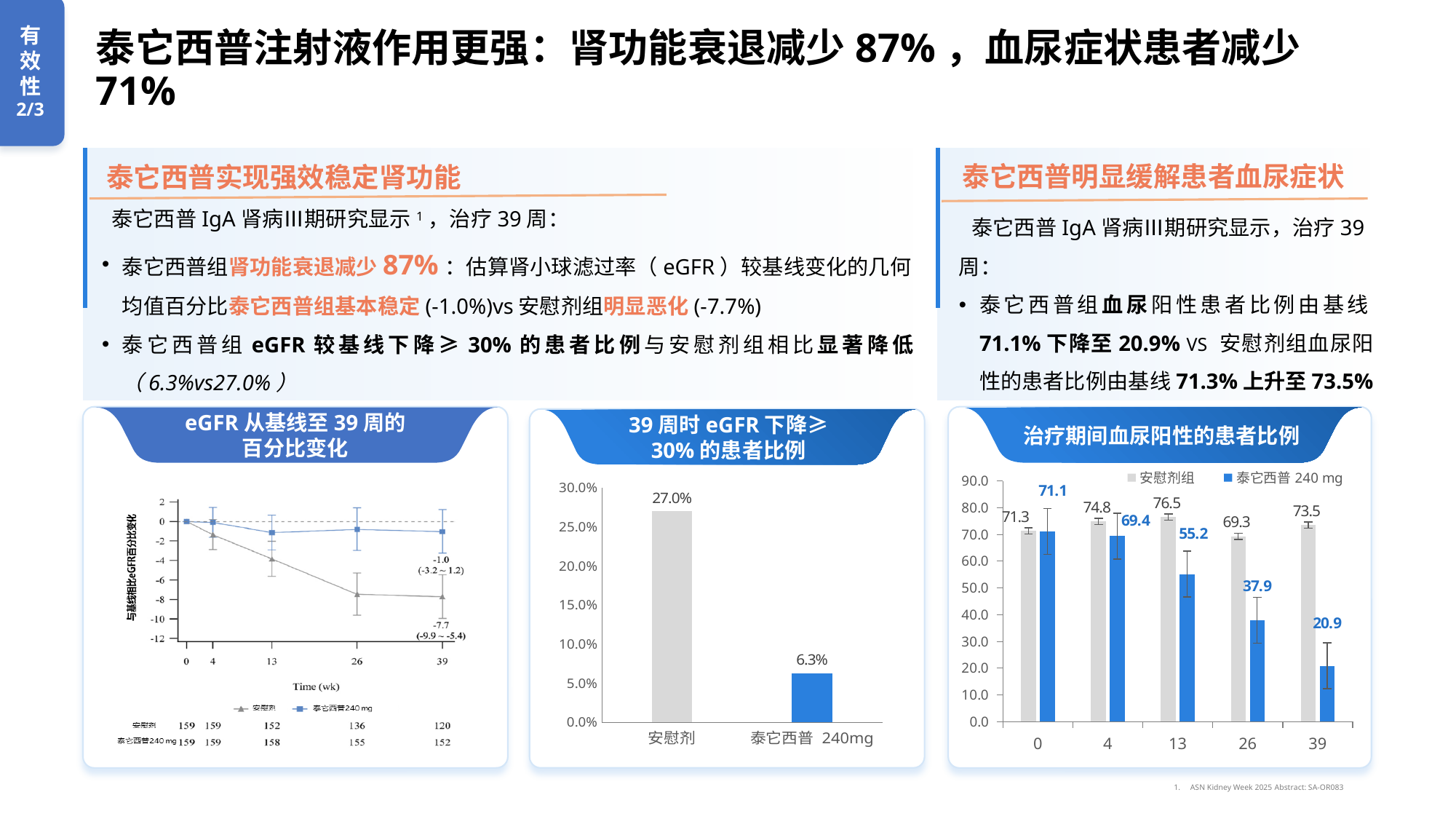
In the chart titled '39 周时 eGFR 下降≥30% 的患者比例', what is the value for 安慰剂? 27.0% In the chart titled '治疗期间血尿阳性的患者比例', what is the value for 泰它西普 240 mg at week 39? 20.9 In the chart titled '治疗期间血尿阳性的患者比例', does the 泰它西普 240 mg value rise or fall from week 0 to week 39? Fall In the chart titled '39 周时 eGFR 下降≥30% 的患者比例', what is the difference between the 安慰剂 value and the 泰它西普 240mg value? 20.7% In the chart titled '治疗期间血尿阳性的患者比例', how many series does the legend list? 2 In the chart titled 'eGFR 从基线至 39 周的百分比变化', what is the value for 泰它西普240 mg at week 39? -1.0 In the chart titled '治疗期间血尿阳性的患者比例', what is the value for 安慰剂组 at week 13? 76.5 In the chart titled '治疗期间血尿阳性的患者比例', at which week is the 安慰剂组 value highest? 13 In the chart titled '39 周时 eGFR 下降≥30% 的患者比例', what is the value for 泰它西普 240mg? 6.3% In the chart titled '治疗期间血尿阳性的患者比例', at which week is the 泰它西普 240 mg value lowest? 39 In the chart titled '治疗期间血尿阳性的患者比例', what is the difference between the 安慰剂组 and 泰它西普 240 mg values at week 26? 31.4 What kind of chart is the one titled '39 周时 eGFR 下降≥30% 的患者比例'? Bar chart